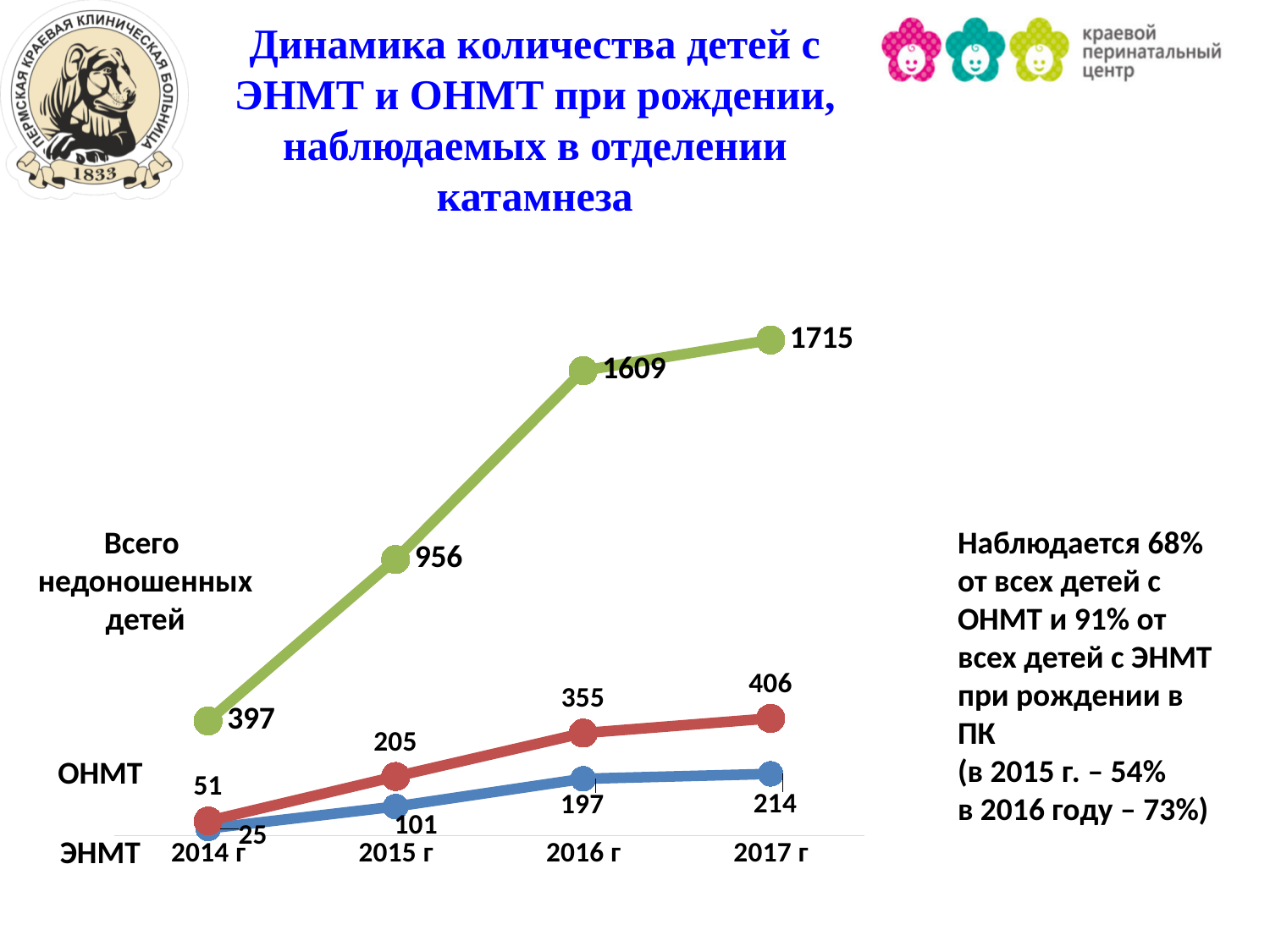
What is the difference between the Всего недоношенных детей values for 2016 г and 2015 г? 653 What is the value for Всего недоношенных детей in 2017 г? 1715 In which year is the value for ЭНМТ the lowest? 2014 г What is the value for Всего недоношенных детей in 2014 г? 397 Do the values for Всего недоношенных детей rise or fall from 2014 г to 2017 г? rise What is the difference between the ОНМТ and ЭНМТ values in 2017 г? 192 What type of chart is shown on the slide? line chart Which is larger in 2015 г: the value for ОНМТ or the value for ЭНМТ? ОНМТ In which year is the value for ОНМТ the highest? 2017 г What is the value for ЭНМТ in 2016 г? 197 How many years are shown on the x axis? 4 What is the value for ОНМТ in 2015 г? 205